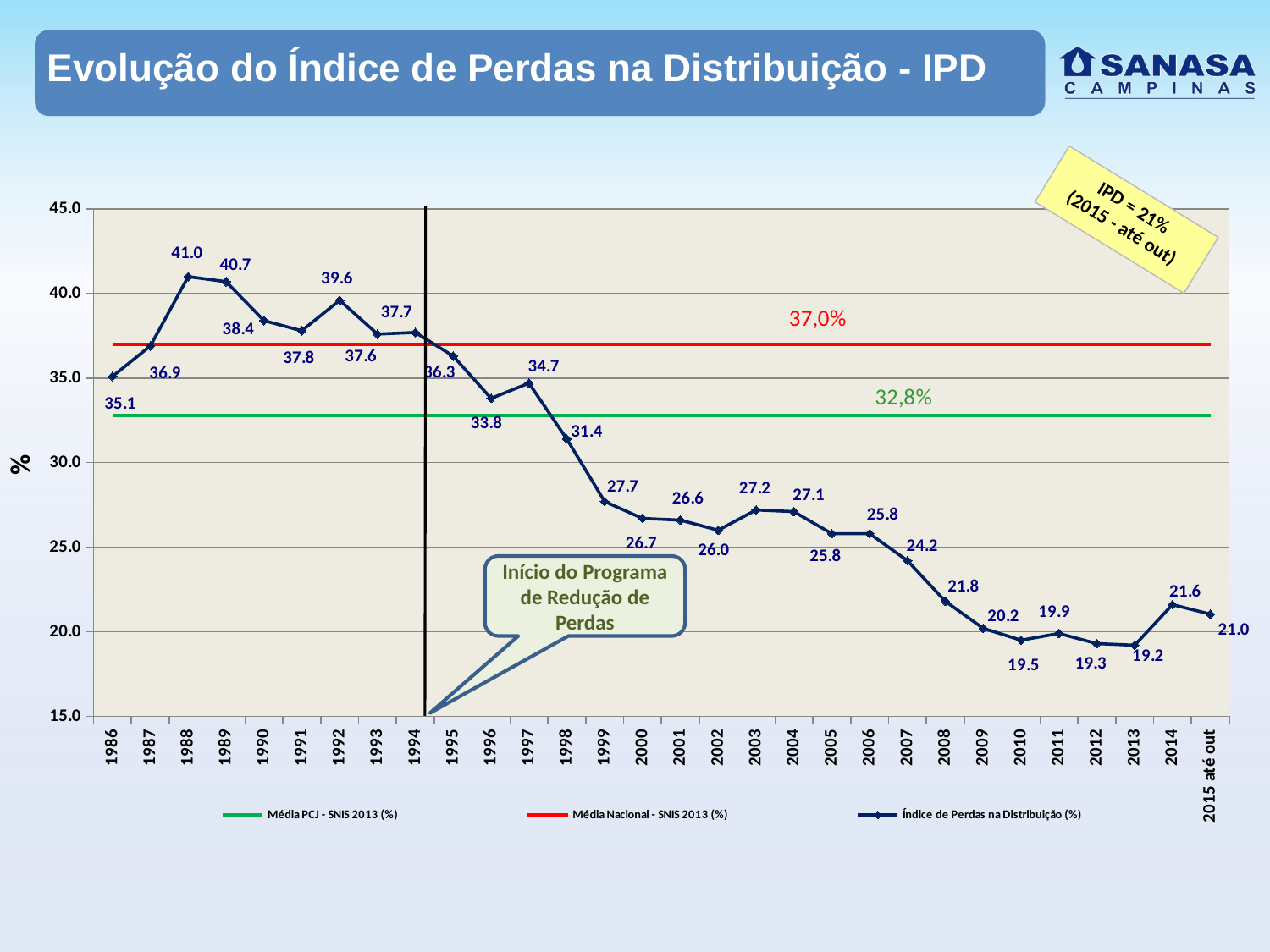
In which year is the Índice de Perdas na Distribuição lowest? 2013 Which year has a higher Índice de Perdas na Distribuição value, 1996 or 1997? 1997 How many series does the legend list? 3 What value does the green Média PCJ - SNIS 2013 line show? 32,8% What value does the red Média Nacional - SNIS 2013 line show? 37,0% In which year is the Índice de Perdas na Distribuição highest? 1988 What is the difference between the Índice de Perdas na Distribuição values for 1988 and 2013? 21.8 What kind of chart is shown on the slide? Line chart What is the Índice de Perdas na Distribuição value for 2015 até out? 21.0 What is the Índice de Perdas na Distribuição value for 1988? 41.0 Does the Índice de Perdas na Distribuição generally rise or fall from 1994 to 2013? Fall What is the Índice de Perdas na Distribuição value for 1998? 31.4